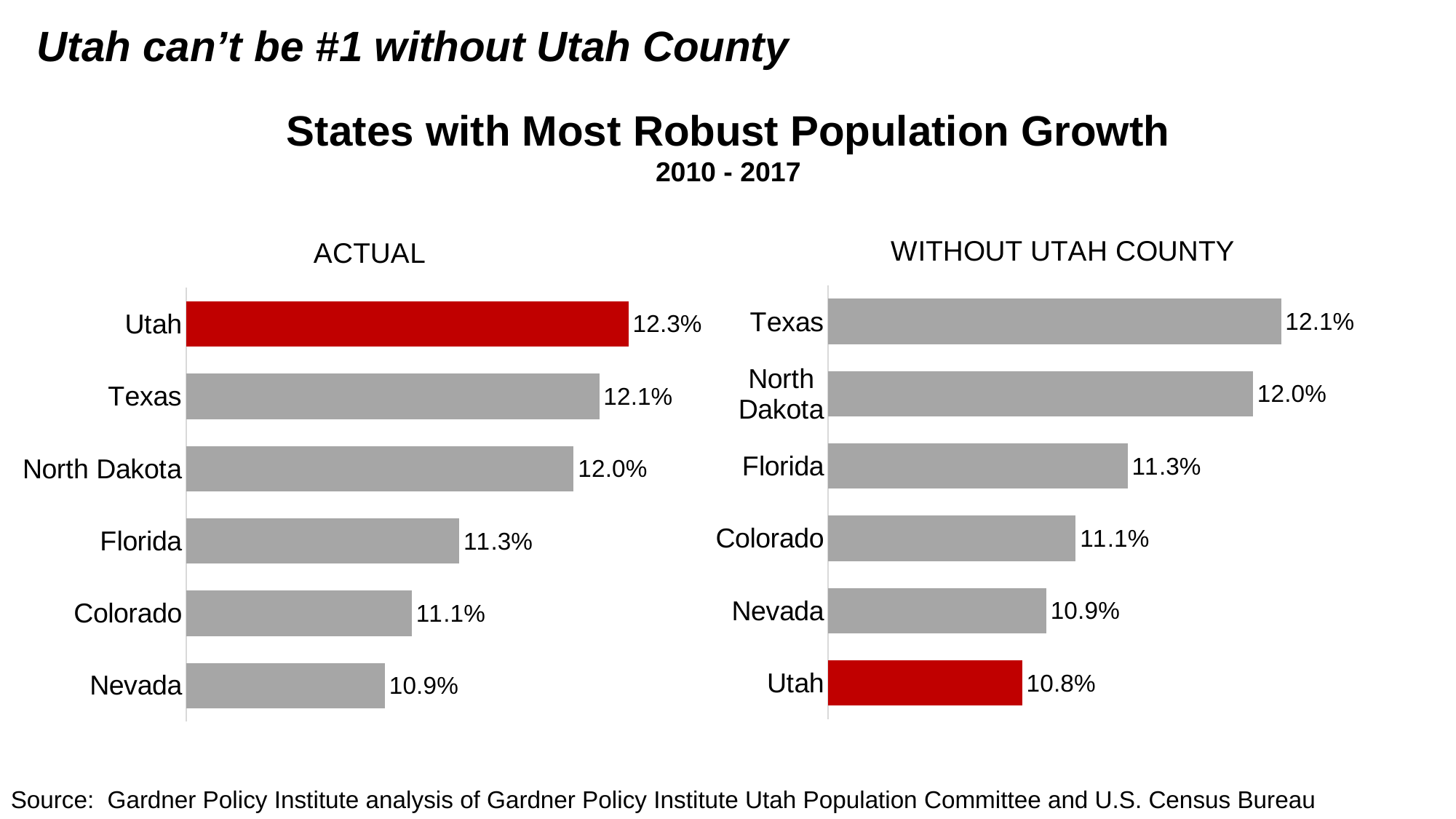
In the ACTUAL chart, what is the difference between Utah and Texas? 0.2% In the ACTUAL chart, which is larger, the value for Florida or the value for Colorado? Florida In the WITHOUT UTAH COUNTY chart, what is the value for Utah? 10.8% In the ACTUAL chart, what is the value for Utah? 12.3% How many states are shown in the ACTUAL chart? 6 What is the difference between Utah's value in the ACTUAL chart and Utah's value in the WITHOUT UTAH COUNTY chart? 1.5% In the ACTUAL chart, which state has the lowest value? Nevada In the ACTUAL chart, which state's bar is coloured red? Utah What kind of chart is the WITHOUT UTAH COUNTY chart? Bar chart In the ACTUAL chart, what is the value for North Dakota? 12.0% In the WITHOUT UTAH COUNTY chart, which state has the lowest value? Utah In the WITHOUT UTAH COUNTY chart, which state has the highest value? Texas